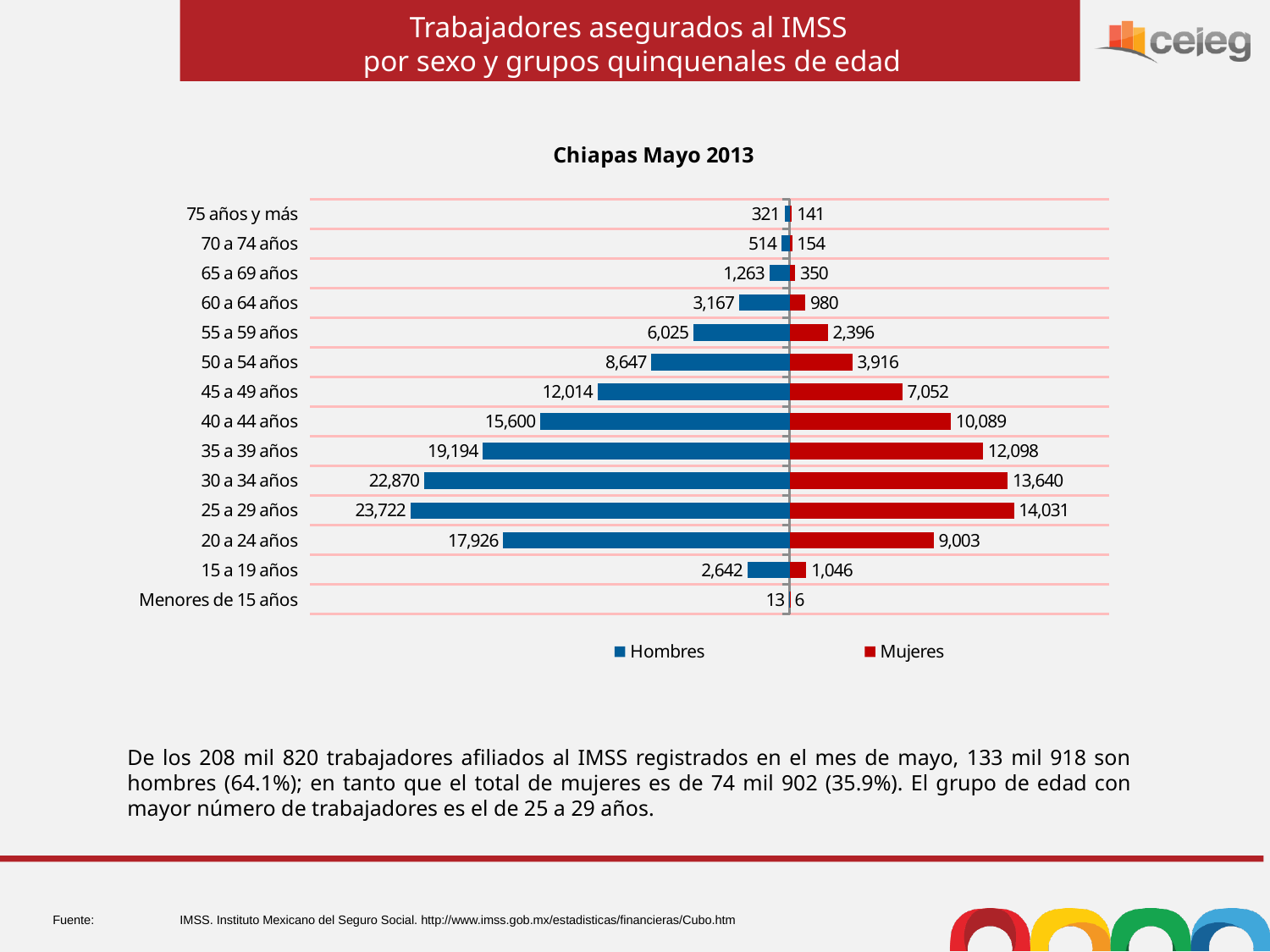
Which is larger in the 20 a 24 años age group, Hombres or Mujeres? Hombres Which age group has the lowest value for Mujeres? Menores de 15 años What is the value for Mujeres in the 40 a 44 años age group? 10,089 What is the difference between Hombres and Mujeres in the 30 a 34 años age group? 9,230 What is the value for Hombres in the 25 a 29 años age group? 23,722 Which age group has the highest value for Hombres? 25 a 29 años How many series does the legend list? 2 What is the value for Mujeres in the 75 años y más age group? 141 How many age groups are shown on the chart? 14 What kind of chart is shown on the slide? Bar chart What is the total of Hombres and Mujeres in the 15 a 19 años age group? 3,688 What is the title of the chart? Chiapas Mayo 2013